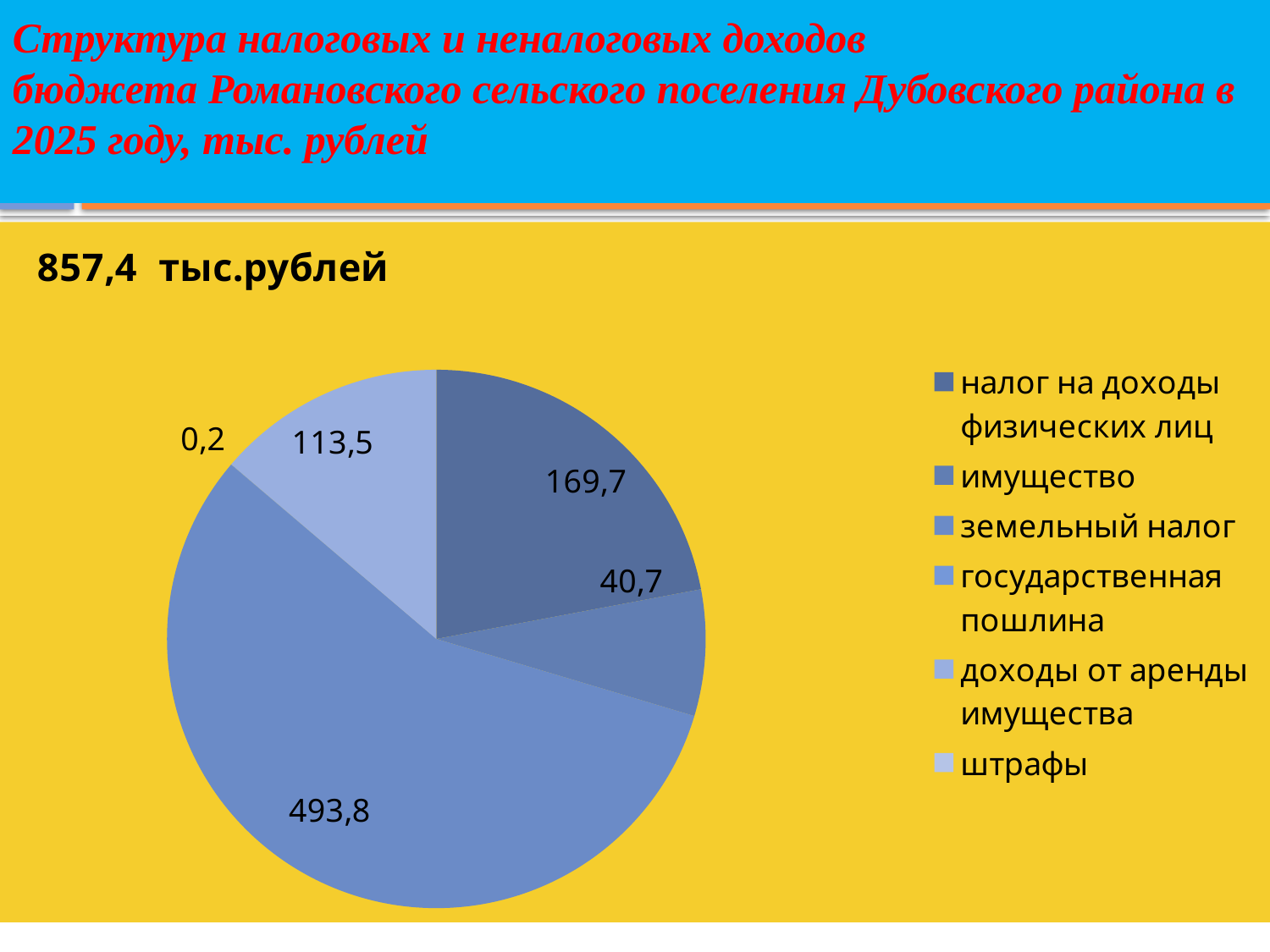
What is the value for налог на доходы физических лиц? 169,7 Which year does the chart title refer to? 2025 Which is larger, the value for налог на доходы физических лиц or the value for имущество? налог на доходы физических лиц Which category has the largest slice of the pie? земельный налог What total amount is stated above the pie chart? 857,4 тыс.рублей How many categories does the legend of the pie chart list? 6 What is the smallest value labeled on the pie chart? 0,2 What is the value for имущество? 40,7 What is the difference between the values for налог на доходы физических лиц and имущество? 129 What is the difference between the values for земельный налог and налог на доходы физических лиц? 324,1 What kind of chart is shown on the slide? pie chart What is the value for земельный налог? 493,8